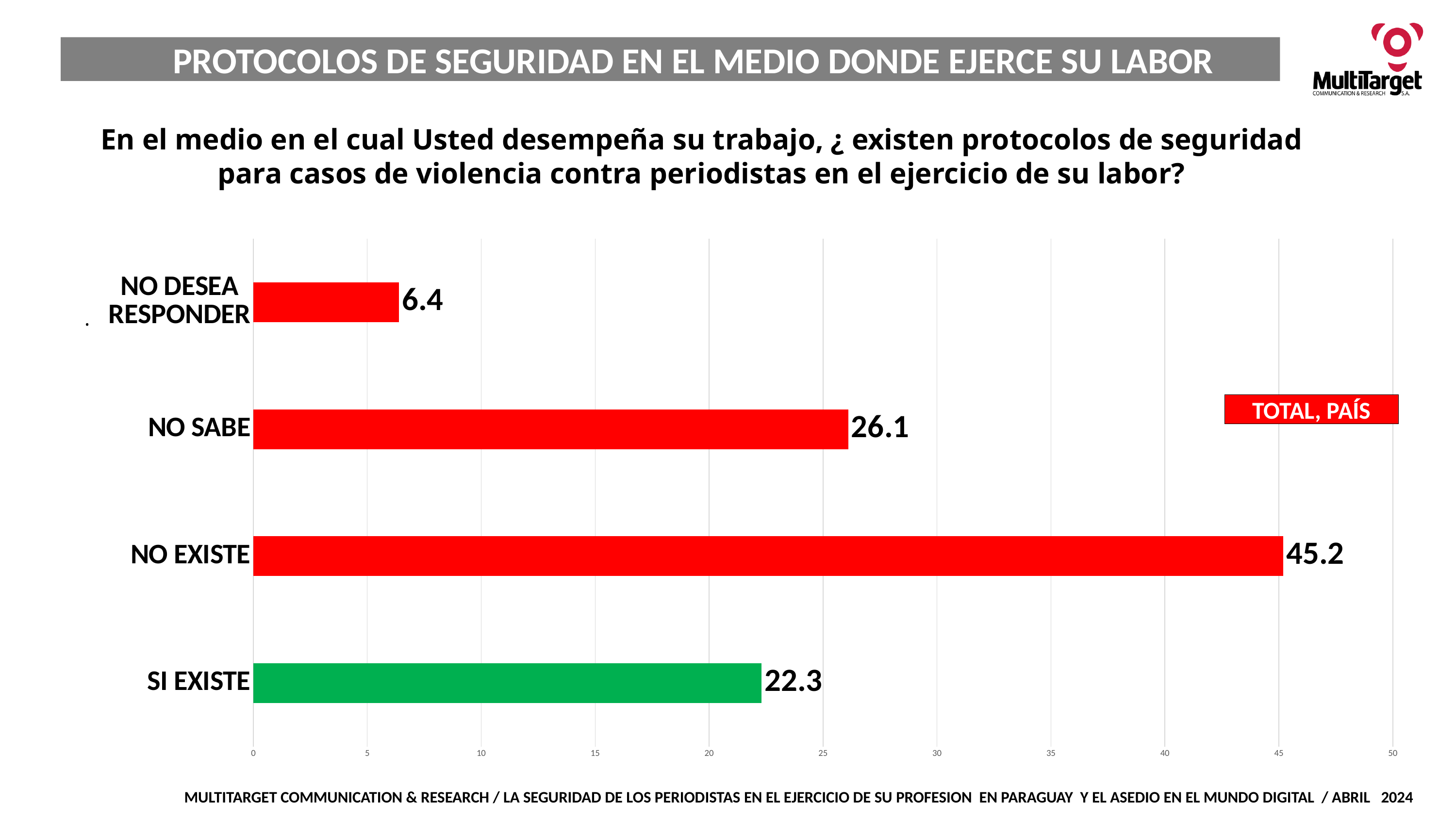
Which category has the lowest value? NO DESEA RESPONDER What is the difference between the values for NO EXISTE and SI EXISTE? 22.9 What is the value for NO DESEA RESPONDER? 6.4 How many categories are shown in the chart? 4 What is the label shown in the chart's legend? TOTAL, PAÍS What is the value for SI EXISTE? 22.3 Is the value for NO EXISTE greater or less than 40? greater Which category has the highest value? NO EXISTE What is the value for NO EXISTE? 45.2 What kind of chart is shown on the slide? bar chart Which is larger, the value for NO SABE or the value for SI EXISTE? NO SABE What is the value for NO SABE? 26.1